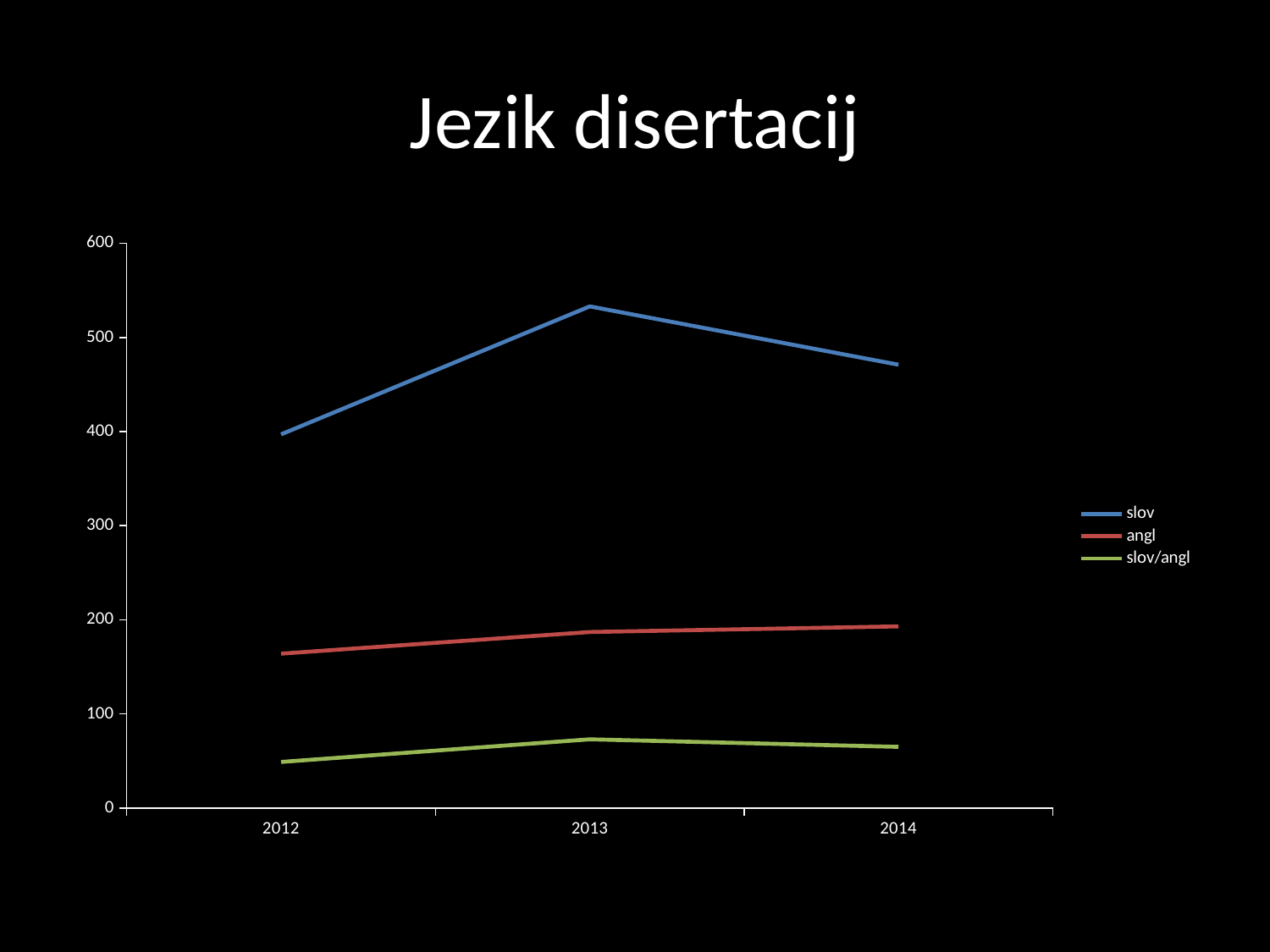
How many series does the legend list? 3 Which series has the higher value in 2014, angl or slov/angl? angl Is the value for angl in 2012 greater or less than 200? less Is the value for slov in 2013 greater or less than 500? greater In which year does the slov series reach its highest value? 2013 What is the title of the chart? Jezik disertacij In which year is the slov/angl series at its lowest value? 2012 Does the angl series rise or fall from 2012 to 2014? rise Which series is drawn in green? slov/angl In which year is the slov series at its lowest value? 2012 How many years are shown on the x axis? 3 What kind of chart is shown on the slide? line chart